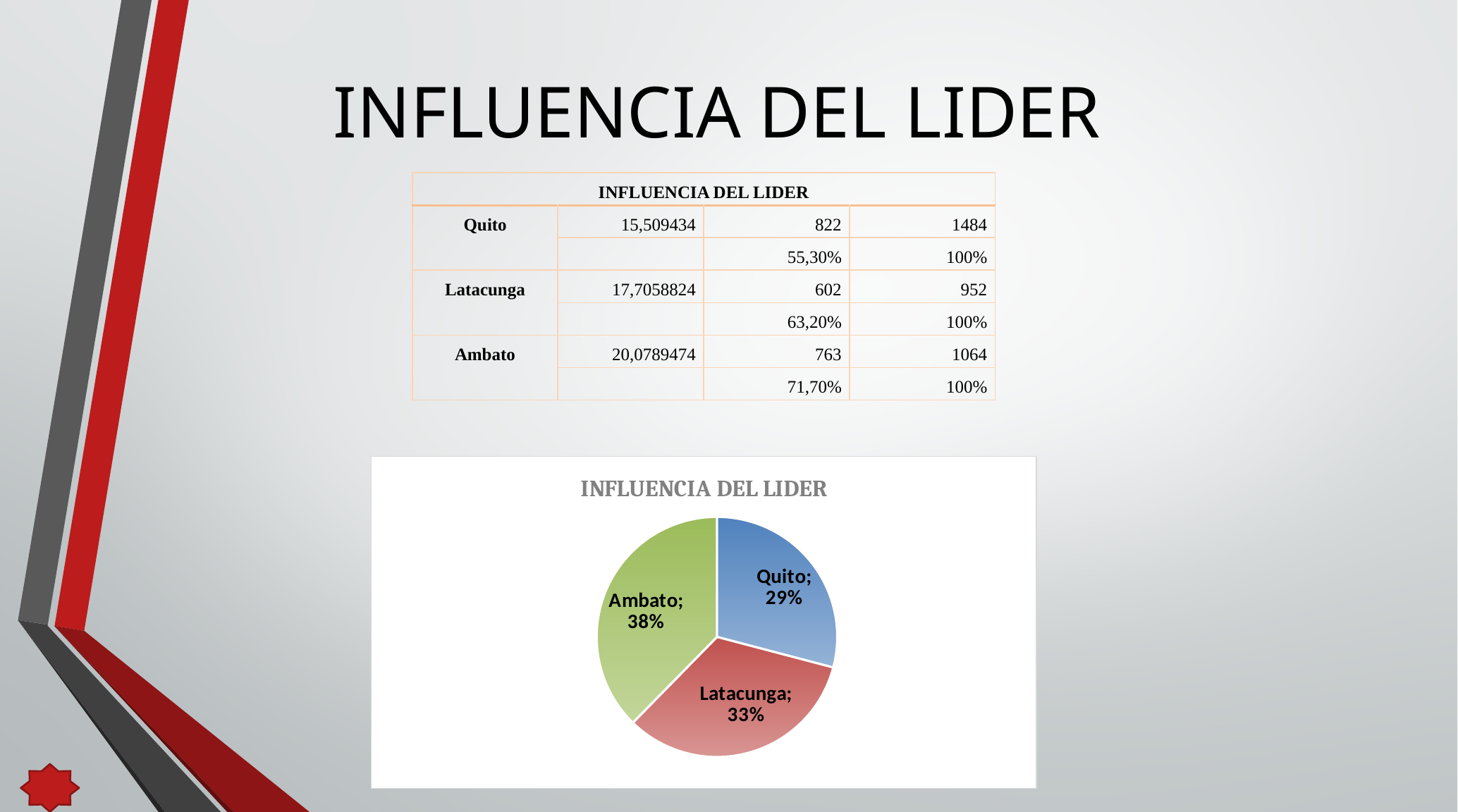
Which city has the smallest slice in the pie chart? Quito Which city has the largest slice in the pie chart? Ambato What is the difference in percentage points between the Latacunga slice and the Quito slice? 4 What is the difference in percentage points between the Ambato slice and the Quito slice? 9 How many slices does the pie chart have? 3 What percentage does the Ambato slice show in the pie chart? 38% What percentage does the Latacunga slice show in the pie chart? 33% Which slice is larger, Latacunga or Quito? Latacunga What is the title of the chart? INFLUENCIA DEL LIDER What percentage does the Quito slice show in the pie chart? 29% What type of chart is shown on the slide? pie chart What colour is the Ambato slice in the pie chart? green